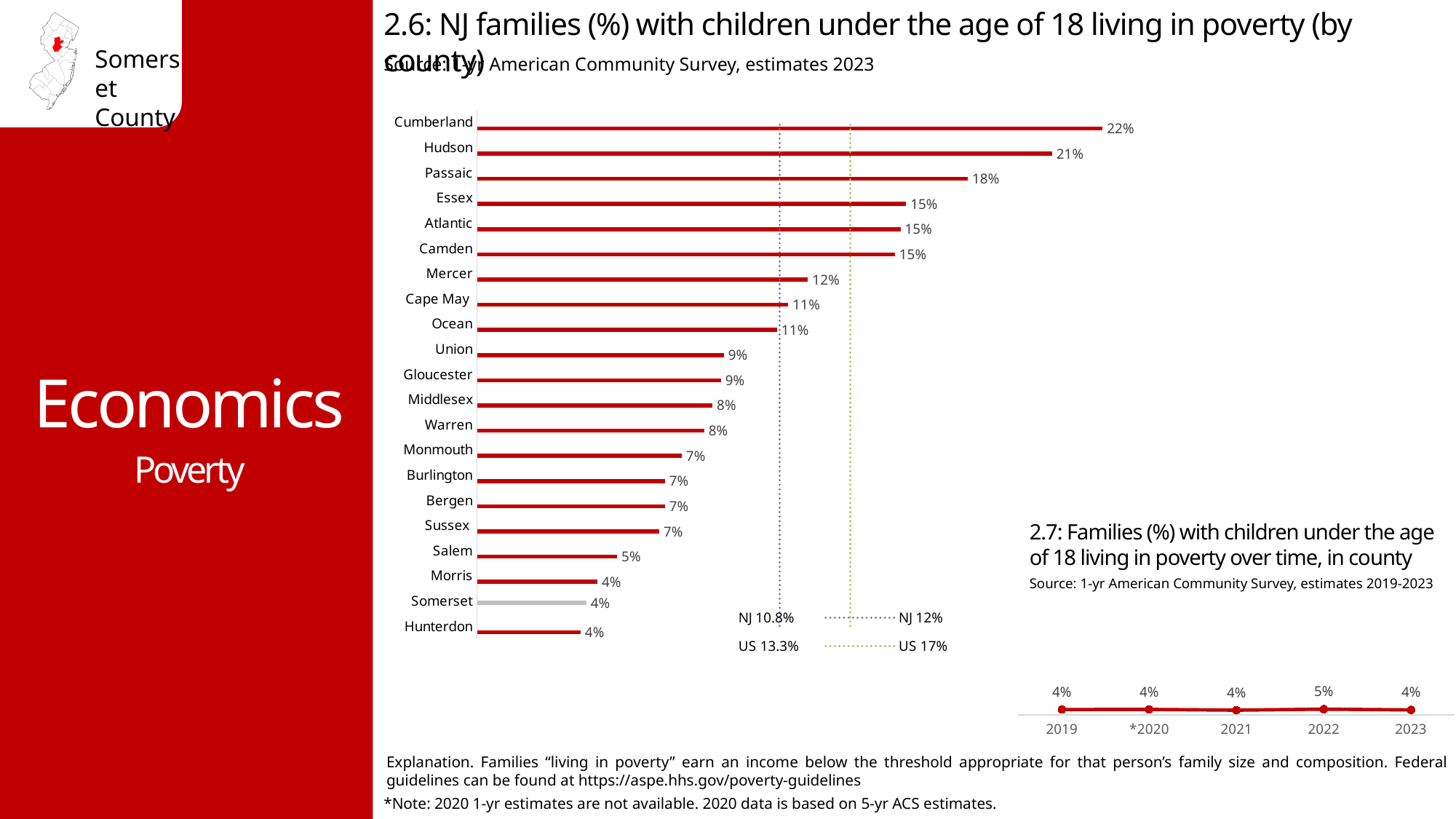
In chart 2.6 (by county), which is larger, the value for Mercer or the value for Union? Mercer In chart 2.6 (by county), what is the difference between Hudson and Passaic? 3% In chart 2.6 (by county), what is the value for Somerset? 4% In chart 2.6 (by county), how many counties are plotted? 21 What kind of chart is chart 2.6 (by county)? Bar chart In chart 2.6 (NJ families with children under 18 living in poverty by county), what is the value for Cumberland? 22% In chart 2.7 (over time, in county), how many years are plotted? 5 In chart 2.6 (by county), which county has the highest value? Cumberland In chart 2.7 (over time, in county), which year has the highest value? 2022 In chart 2.7 (families in poverty over time, in county), what is the value for 2022? 5% What kind of chart is chart 2.7 (over time, in county)? Line chart